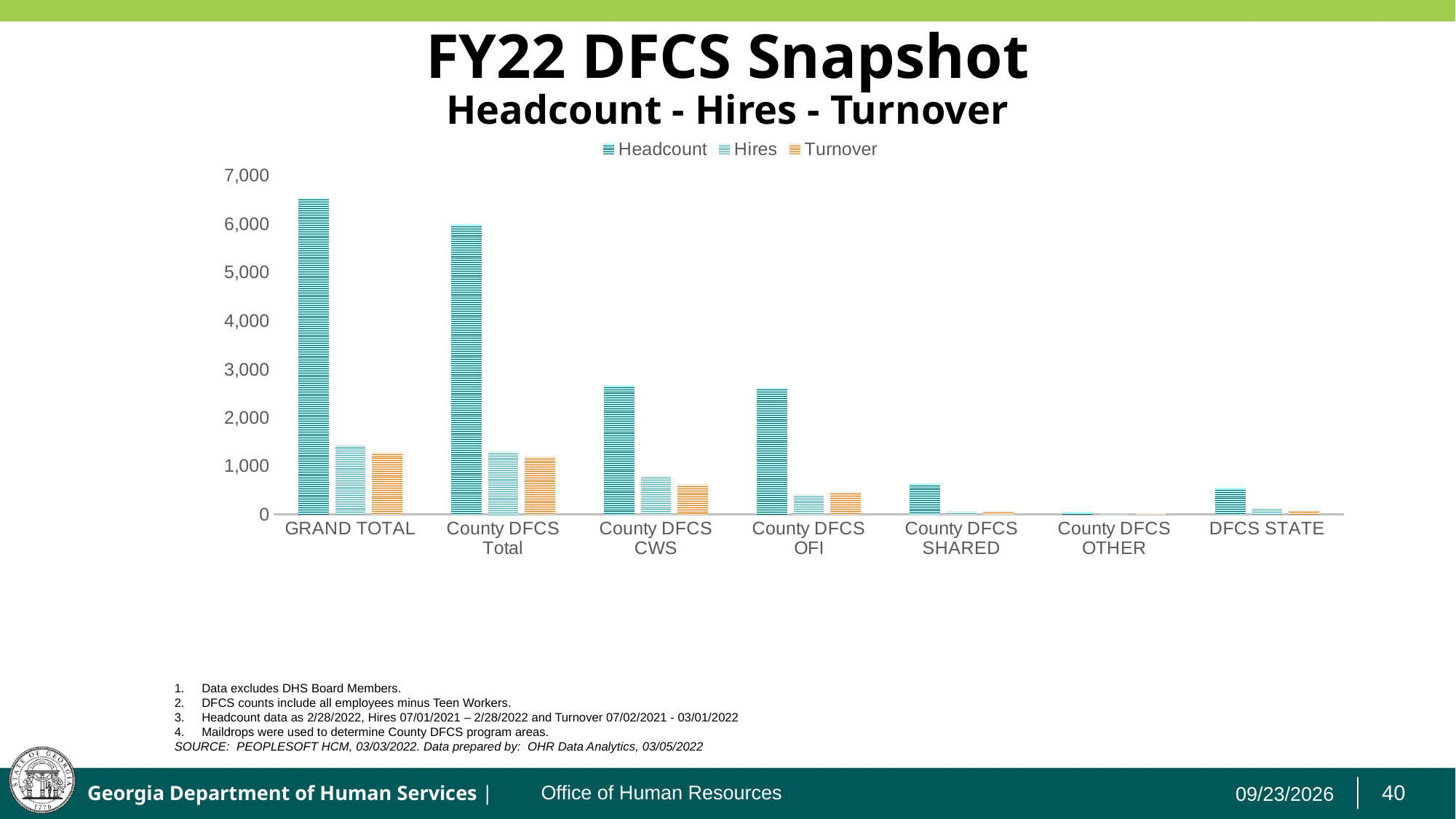
Is the Hires value for GRAND TOTAL greater or less than 1,000? greater How many series does the chart legend list? 3 How many categories are shown along the x axis of the chart? 7 Is the Headcount value for GRAND TOTAL greater or less than 6,000? greater Which is larger, the Hires value for County DFCS CWS or the Hires value for County DFCS OFI? County DFCS CWS What kind of chart is shown on the slide? Bar chart Is the Headcount value for County DFCS Total greater or less than 5,000? greater Which category has the lowest Headcount value? County DFCS OTHER What are the three series named in the chart legend? Headcount, Hires, Turnover Which category has the highest Headcount value? GRAND TOTAL